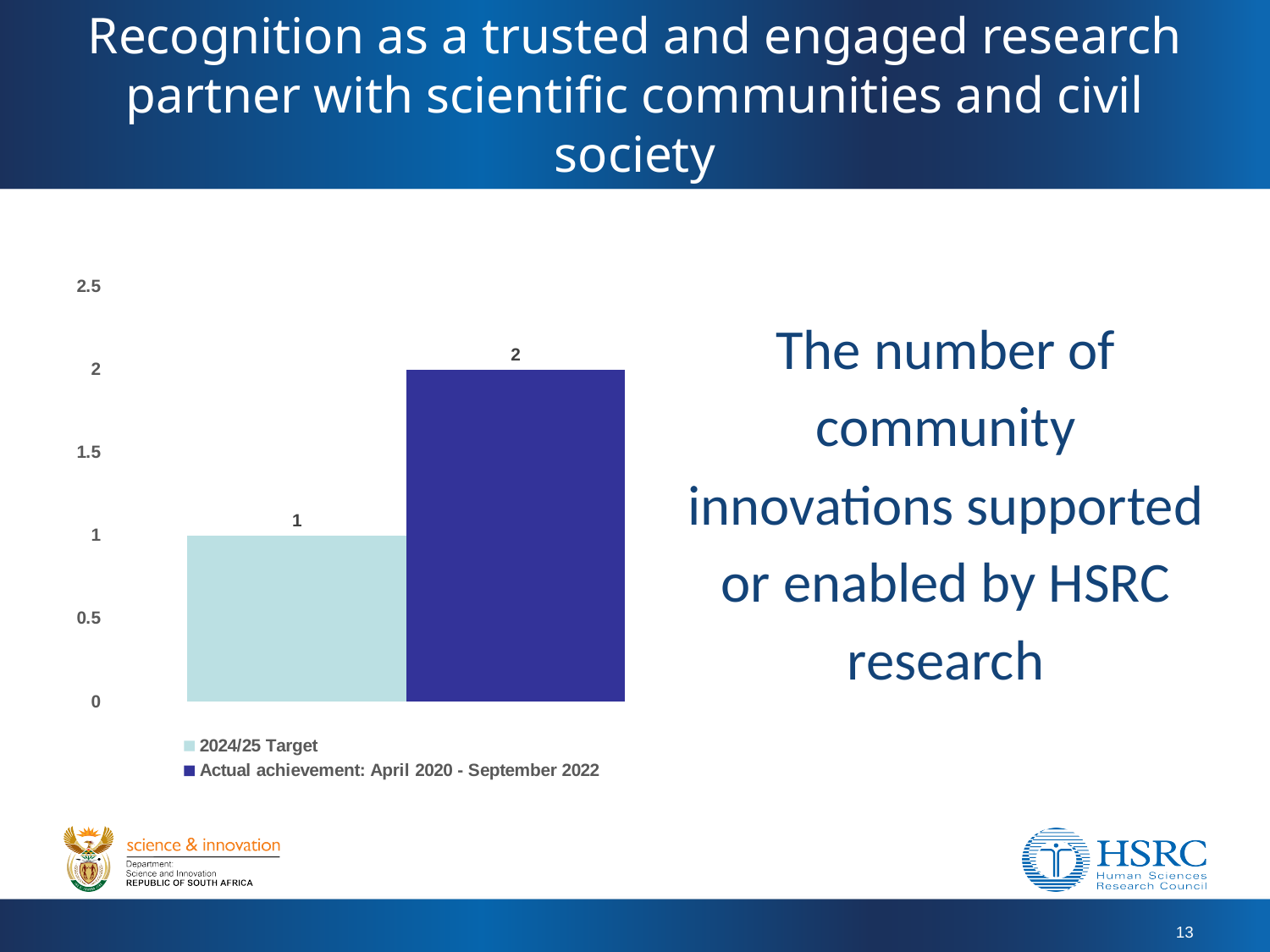
Which bar is the lowest on the chart? 2024/25 Target What is the difference between the Actual achievement value and the 2024/25 Target value? 1 What colour is the 2024/25 Target bar? Light blue Which series has the higher value, 2024/25 Target or Actual achievement: April 2020 - September 2022? Actual achievement: April 2020 - September 2022 What is the value of the 2024/25 Target bar? 1 How many series does the legend list? 2 Is the value for Actual achievement: April 2020 - September 2022 greater or less than 1.5? greater What kind of chart is shown on the slide? Bar chart Which bar is the highest on the chart? Actual achievement: April 2020 - September 2022 How many bars are plotted on the chart? 2 What is the highest value shown on the vertical axis? 2.5 What is the value of the Actual achievement: April 2020 - September 2022 bar? 2